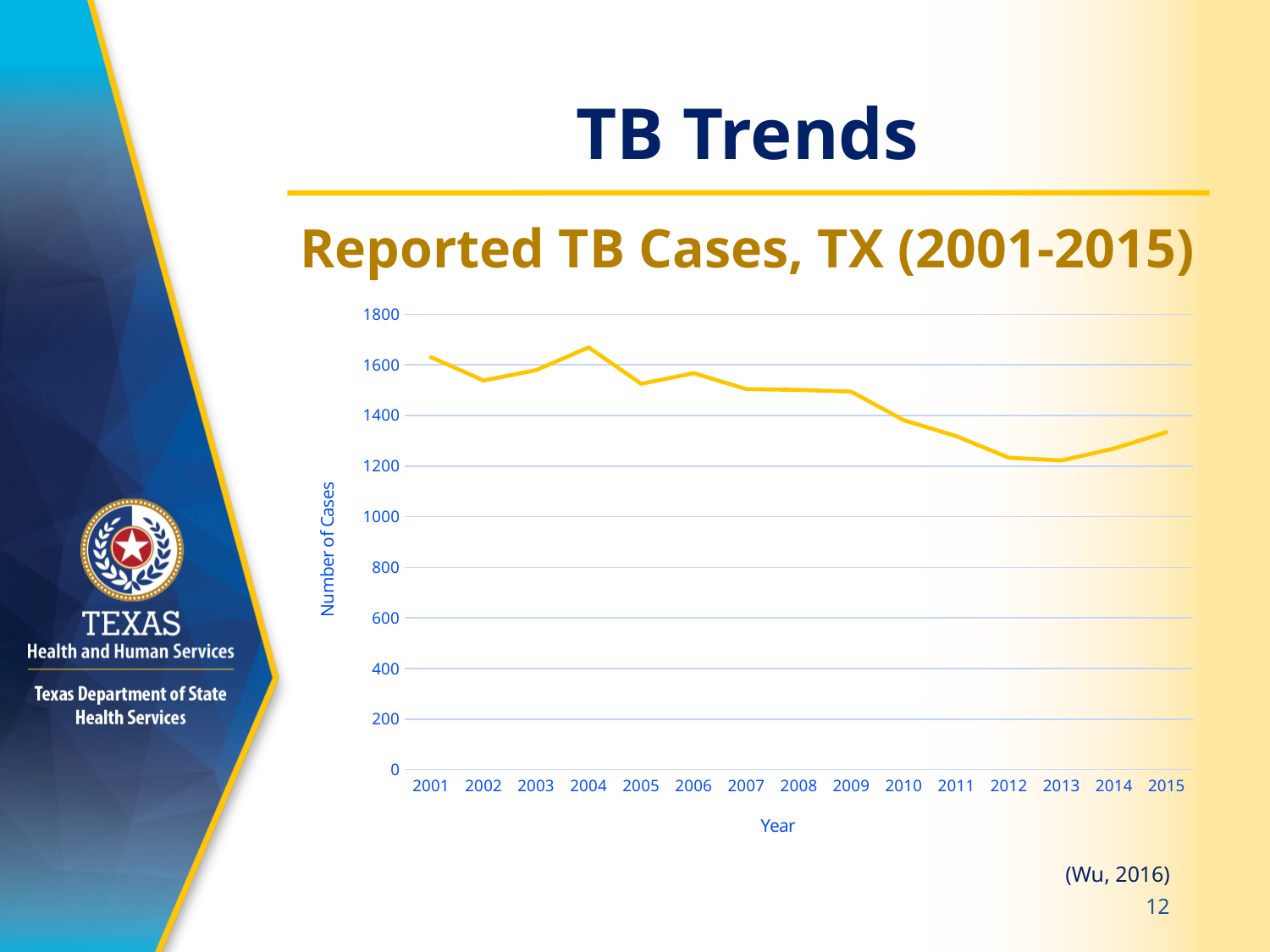
How many years are plotted on the x axis of the chart? 15 Is the value for 2004 greater or less than 1600? greater What is the title of the chart? Reported TB Cases, TX (2001-2015) Which year has the highest number of reported TB cases? 2004 Is the value for 2005 greater or less than 1600? less What kind of chart is shown on the slide? Line chart Is the value for 2009 greater or less than 1400? greater What is the label of the vertical axis of the chart? Number of Cases Which year has more reported TB cases, 2001 or 2015? 2001 Overall, do reported TB cases rise or fall from 2001 to 2015? Fall